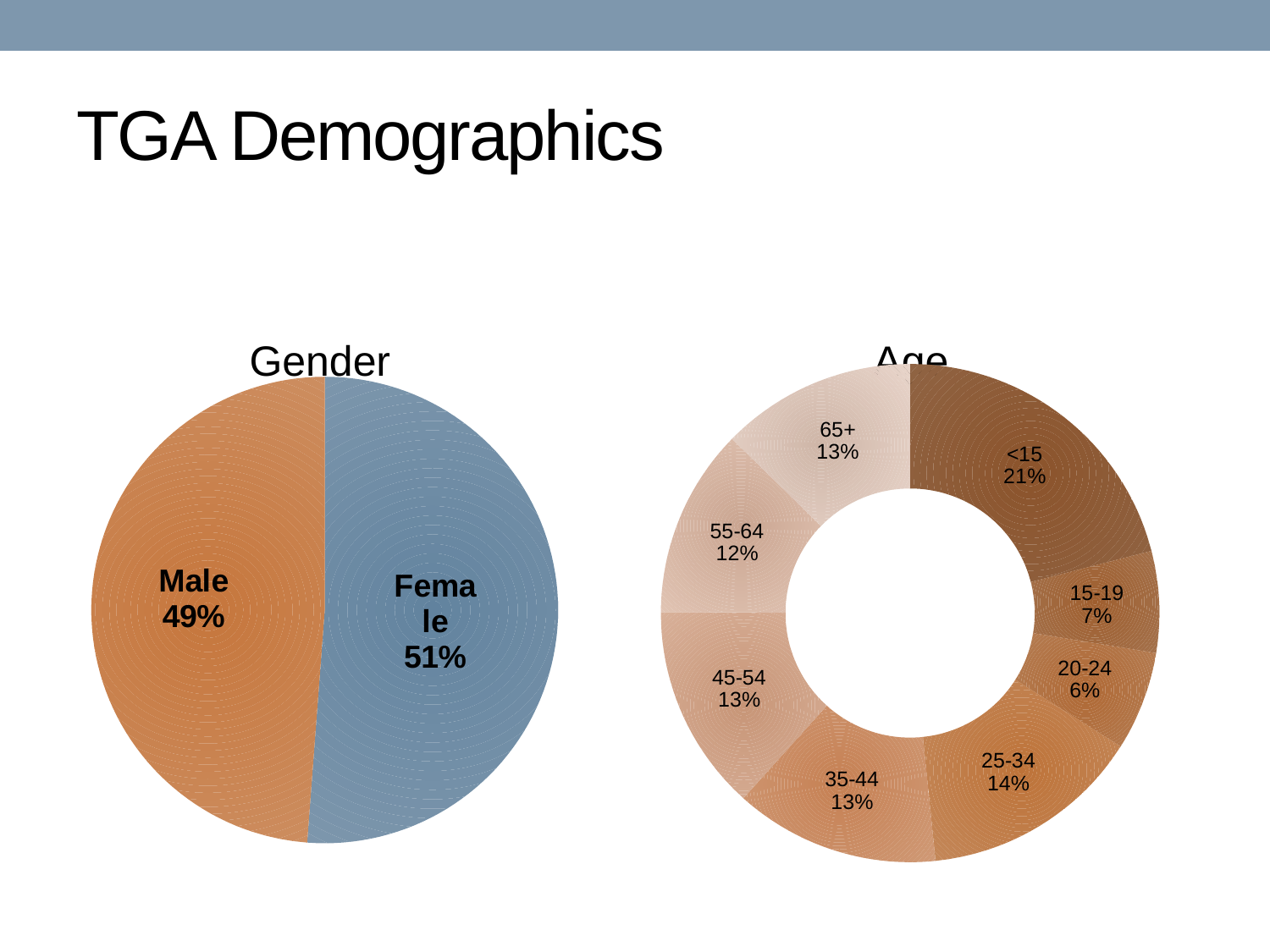
In the Gender chart, what percentage is Male? 49% In the Age chart, what percentage is the <15 group? 21% In the Age chart, what is the difference between the <15 and 25-34 shares? 7% In the Age chart, how many age groups are shown? 8 In the Age chart, what percentage is the 55-64 group? 12% In the Gender chart, what is the difference between the Female and Male percentages? 2% What kind of chart is the Gender chart? Pie chart In the Age chart, which age group has the smallest share? 20-24 In the Gender chart, what percentage is Female? 51% In the Age chart, which age group has the largest share? <15 In the Gender chart, which is larger, Male or Female? Female What kind of chart is the Age chart? Doughnut chart